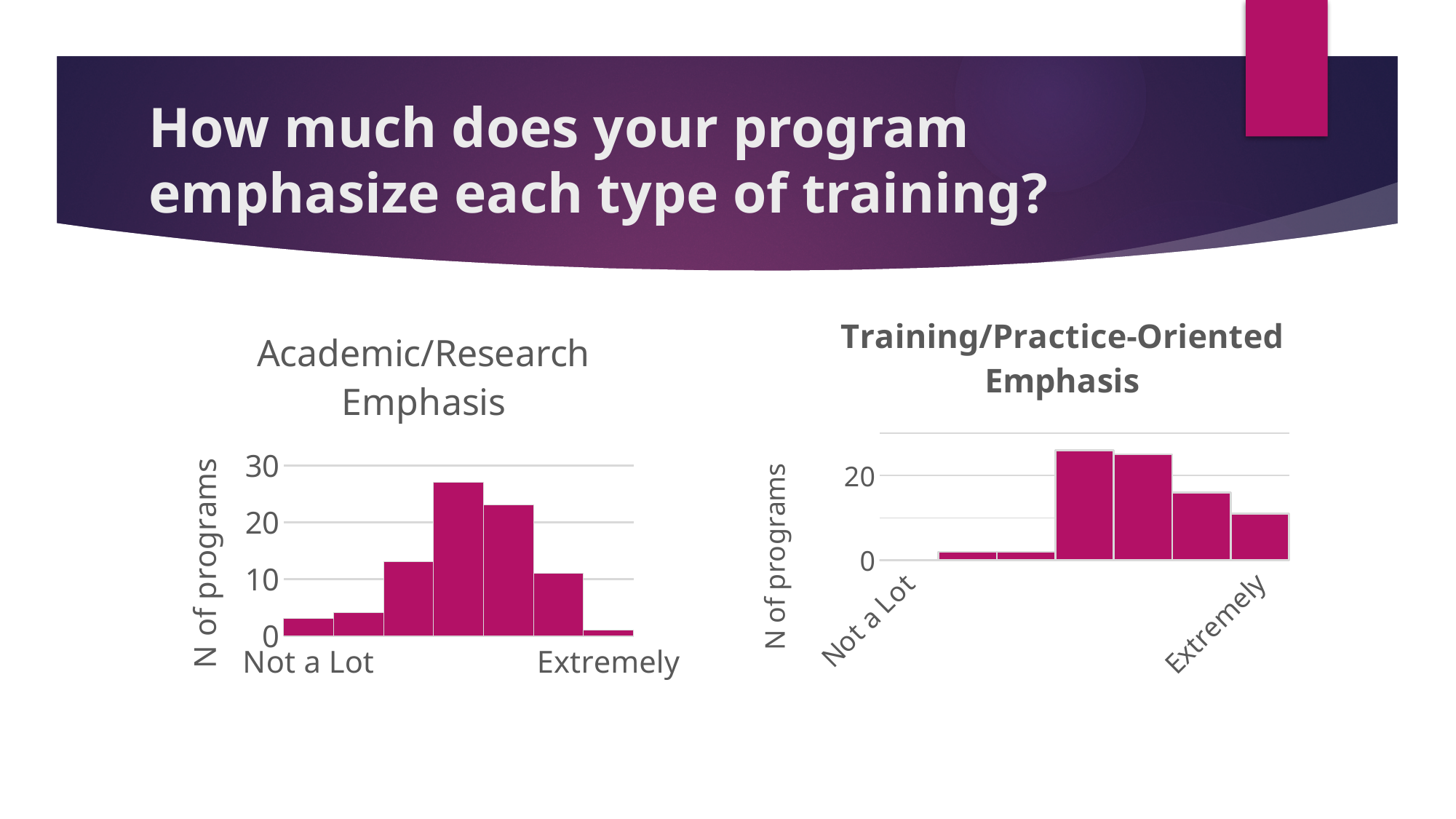
What is the y-axis label of the Academic/Research Emphasis chart? N of programs In the Training/Practice-Oriented Emphasis chart, do the values rise or fall from the tallest bar toward Extremely? fall In the Academic/Research Emphasis chart, is the value for Not a Lot greater or less than 10? less In the Academic/Research Emphasis chart, is the tallest bar greater or less than 20? greater How many bars are plotted in the Academic/Research Emphasis chart? 7 In the Academic/Research Emphasis chart, which bar is the lowest? Extremely In the Training/Practice-Oriented Emphasis chart, is the value for Extremely greater or less than 20? less What kind of chart is the Academic/Research Emphasis chart? bar chart What is the title of the chart on the right side of the slide? Training/Practice-Oriented Emphasis In the Academic/Research Emphasis chart, which is larger, the value for Not a Lot or the value for Extremely? Not a Lot